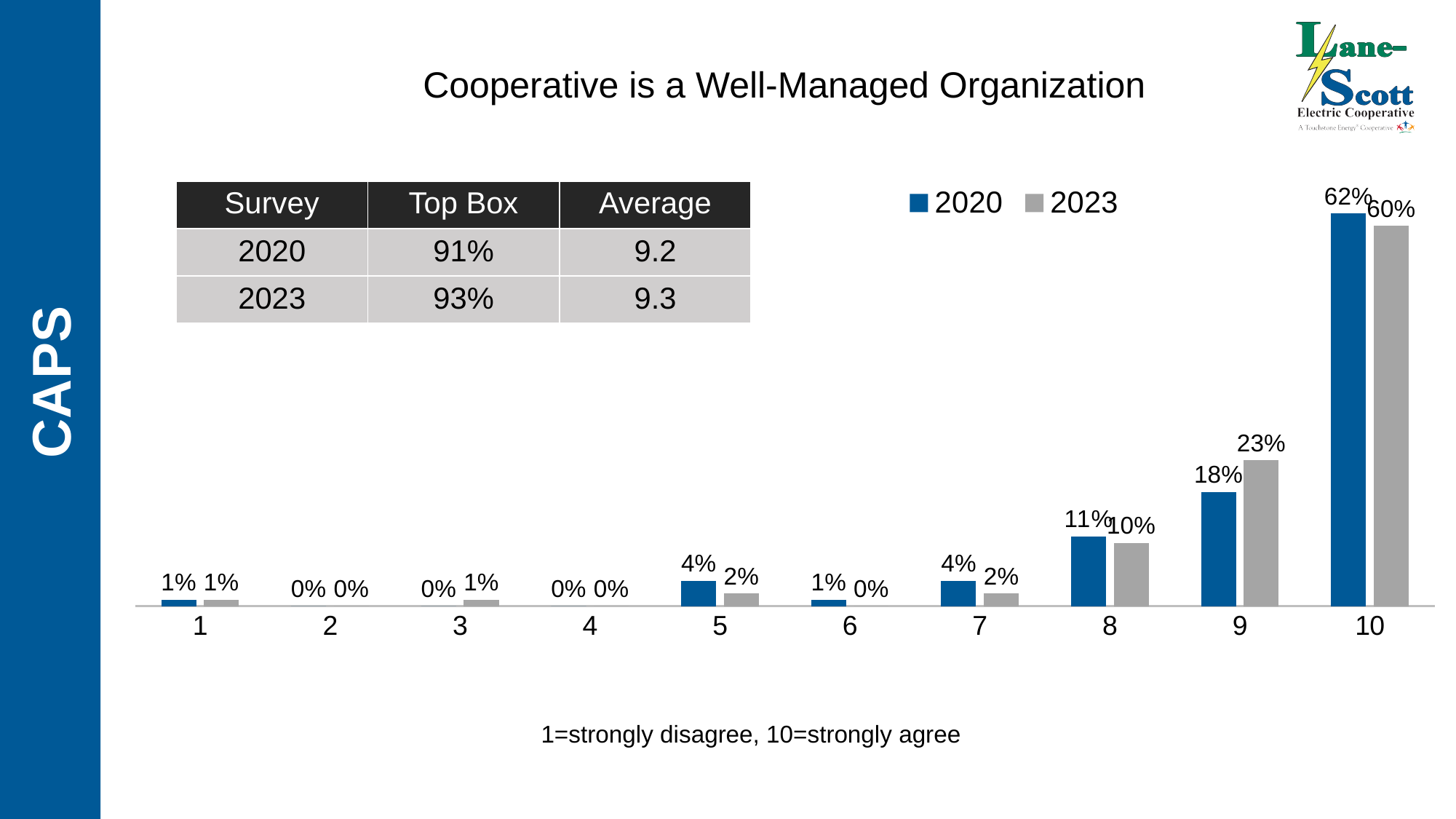
For category 7, which series has the larger value, 2020 or 2023? 2020 What is the value for category 5 in the 2023 series? 2% What is the title of the chart? Cooperative is a Well-Managed Organization How many categories are shown on the x axis? 10 What is the value for category 8 in the 2020 series? 11% What is the value for category 9 in the 2023 series? 23% How many series does the legend list? 2 What is the value for category 10 in the 2020 series? 62% Which category has the highest value in the 2023 series? 10 What is the difference between the 2020 and 2023 values for category 10? 2% What is the difference between the 2023 and 2020 values for category 9? 5% What kind of chart is shown on the slide? bar chart